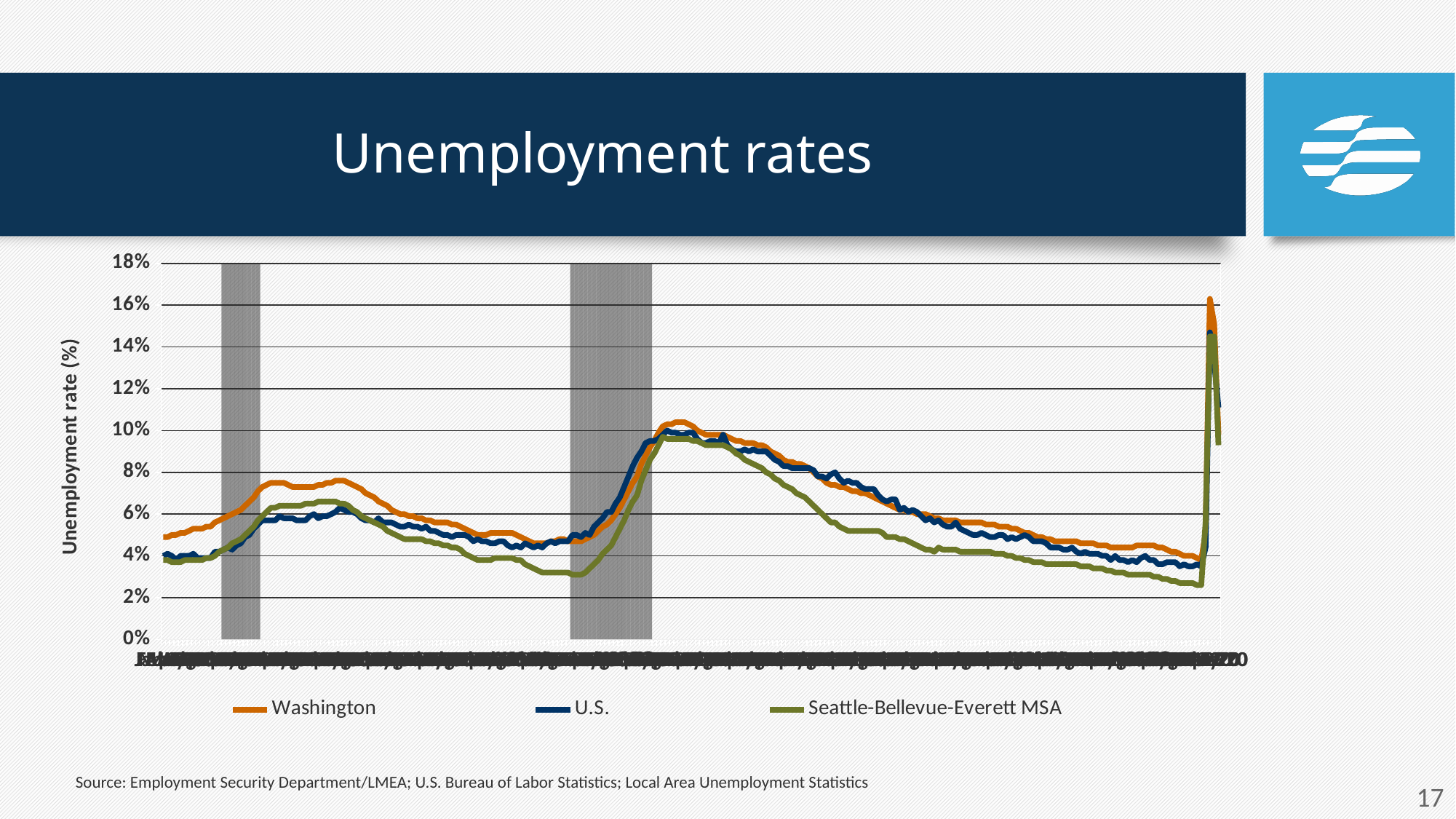
What is the title of the chart? Unemployment rates Is the highest value reached by the U.S. series greater or less than 12%? greater How many series does the legend list? 3 Is the highest value reached by the Washington series greater or less than 14%? greater Is the peak of the Seattle-Bellevue-Everett MSA series in the middle of the chart (around the second shaded band) greater or less than 8%? greater Which series has the lowest value just before the sharp spike at the right end of the chart? Seattle-Bellevue-Everett MSA What is the label on the vertical axis? Unemployment rate (%) What is the highest value shown on the vertical axis? 18% Which series reaches the highest peak on the chart? Washington What kind of chart is shown on the slide? line chart